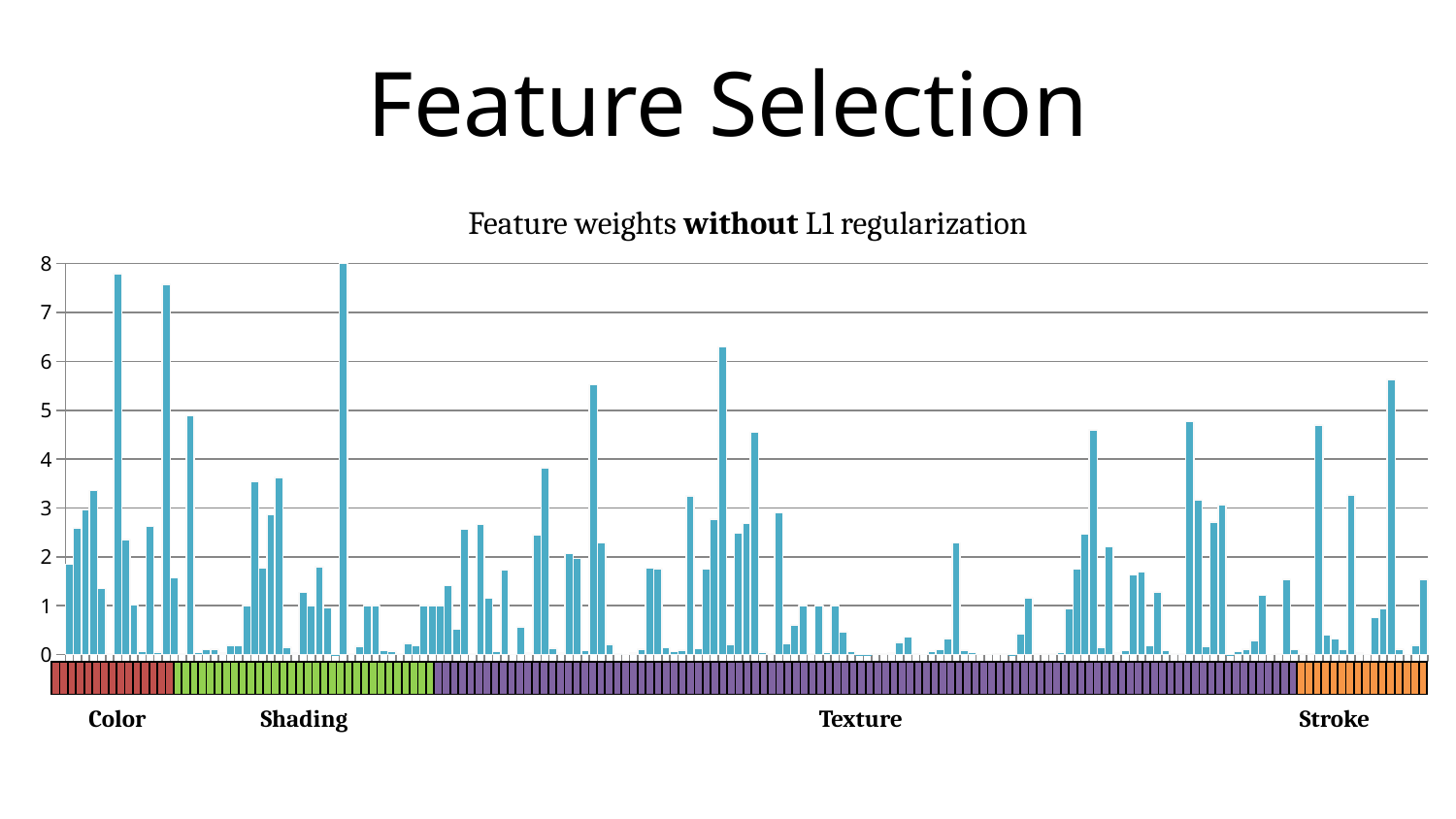
How many feature groups are labeled along the x axis of the chart? 4 Which feature group spans the most bars along the x axis? Texture Which feature group is labeled furthest to the right on the x axis? Stroke Which feature group has a taller maximum bar, Texture or Stroke? Texture Is the tallest bar in the Color group greater or less than 7? greater What is the title of the chart? Feature weights without L1 regularization Is the tallest bar in the Texture group greater or less than 6? greater What kind of chart is shown on the slide? bar chart Is the tallest bar in the chart greater or less than 7? greater Which feature group contains the tallest bar in the chart? Shading What is the highest value shown on the y axis of the chart? 8